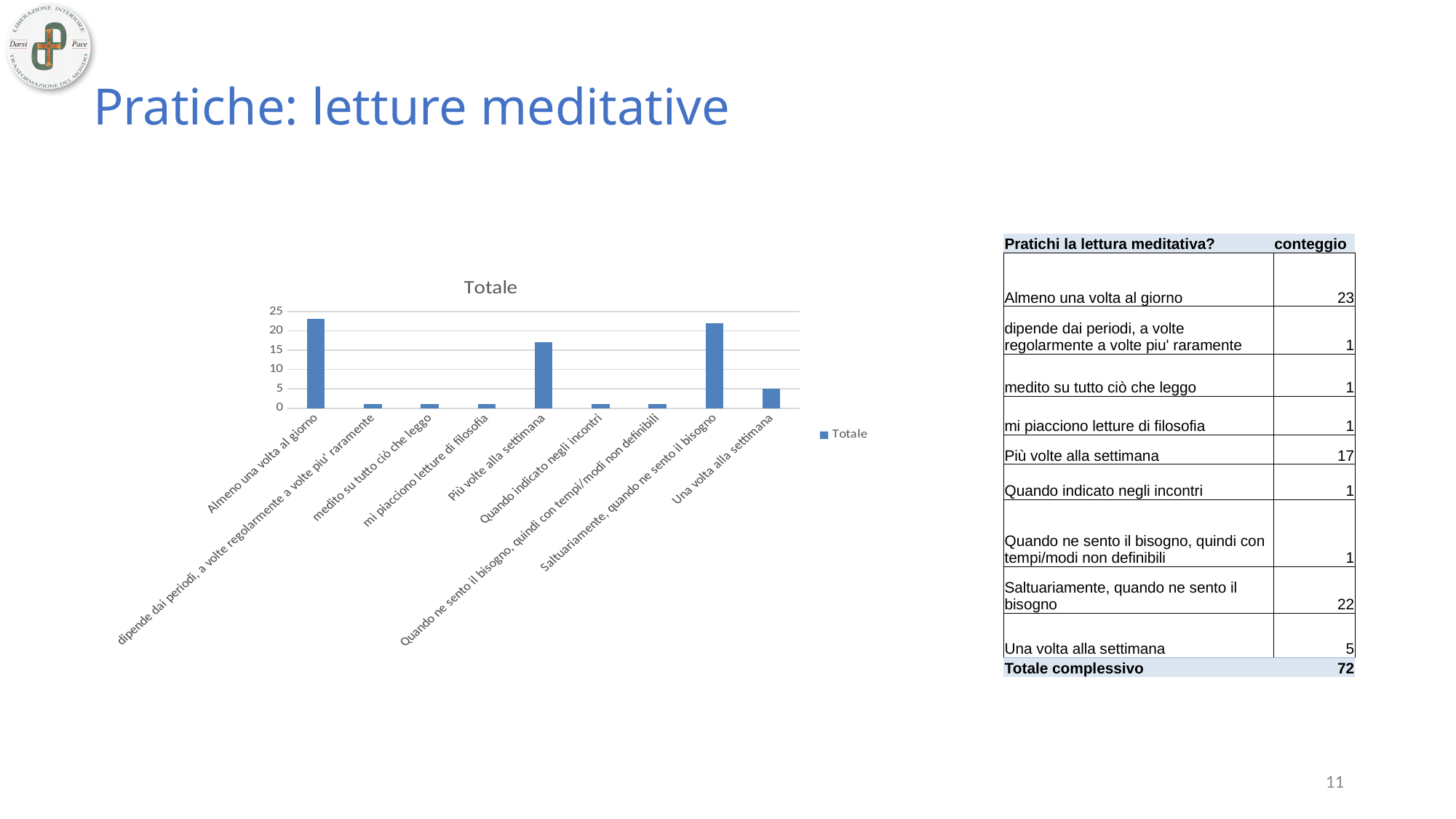
What is the value for 'Saltuariamente, quando ne sento il bisogno'? 22 What is the value for 'Almeno una volta al giorno'? 23 Which is larger, the value for 'Più volte alla settimana' or the value for 'Una volta alla settimana'? Più volte alla settimana How many categories are shown on the x axis of the chart? 9 What kind of chart is shown on the slide? bar chart What is the title of the chart? Totale Which category has the highest bar in the chart? Almeno una volta al giorno What is the value for 'Più volte alla settimana'? 17 What is the value for 'Una volta alla settimana'? 5 What is the difference between the values for 'Almeno una volta al giorno' and 'Più volte alla settimana'? 6 How many series does the chart legend list? 1 Is the value for 'Saltuariamente, quando ne sento il bisogno' greater or less than 20? greater